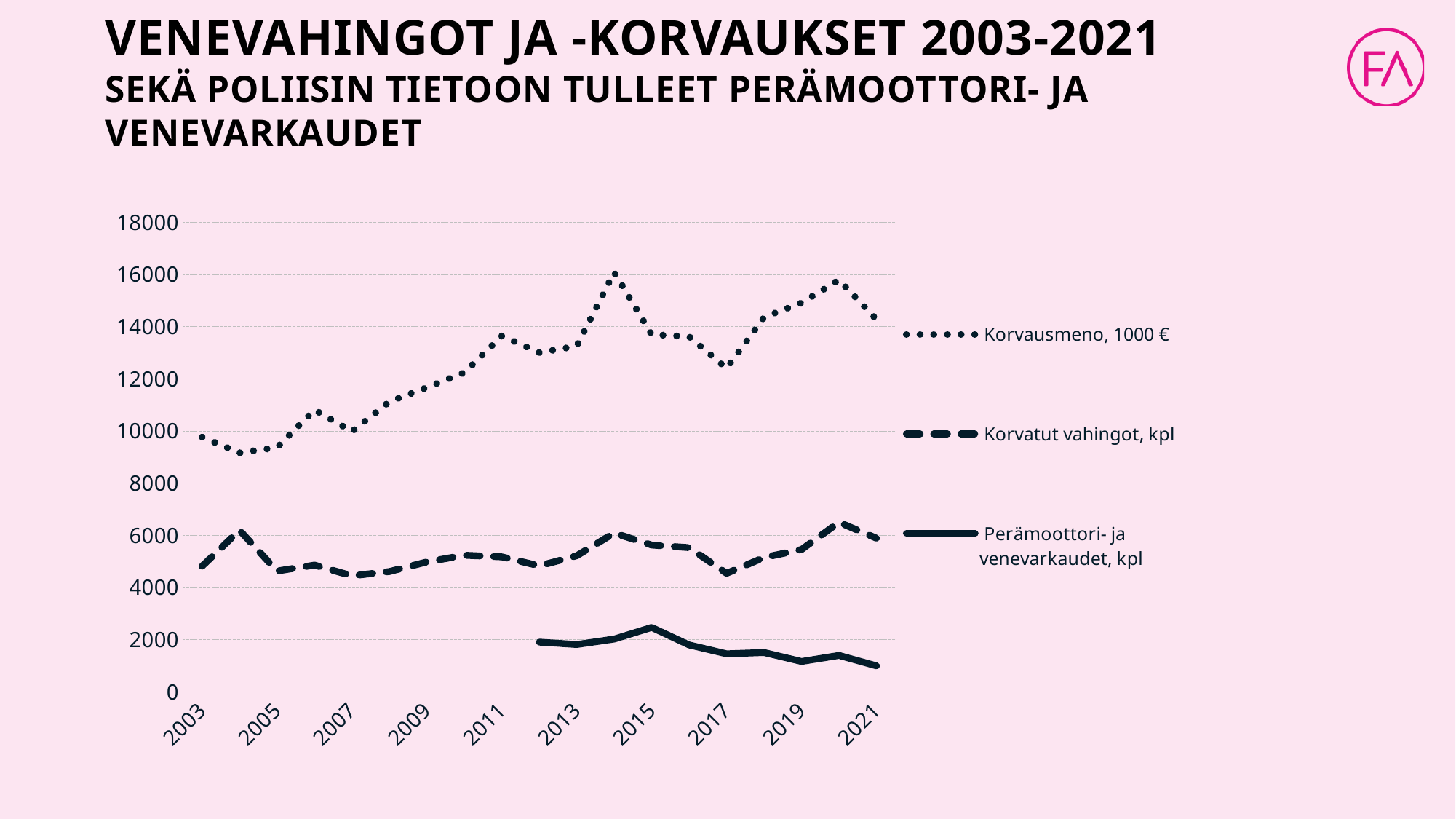
How many series does the legend list? 3 Is the value of Perämoottori- ja venevarkaudet, kpl in 2015 greater or less than 2000? greater What kind of chart is shown on the slide? line chart Does Perämoottori- ja venevarkaudet, kpl rise or fall from 2015 to 2021? fall Is the value of Korvausmeno, 1000 € in 2003 greater or less than 12000? less How many year labels are shown on the x axis? 10 Is the value of Korvatut vahingot, kpl in 2021 greater or less than 8000? less Which is larger for Korvausmeno, 1000 €: the value in 2014 or the value in 2017? 2014 In which year is Perämoottori- ja venevarkaudet, kpl at its highest? 2015